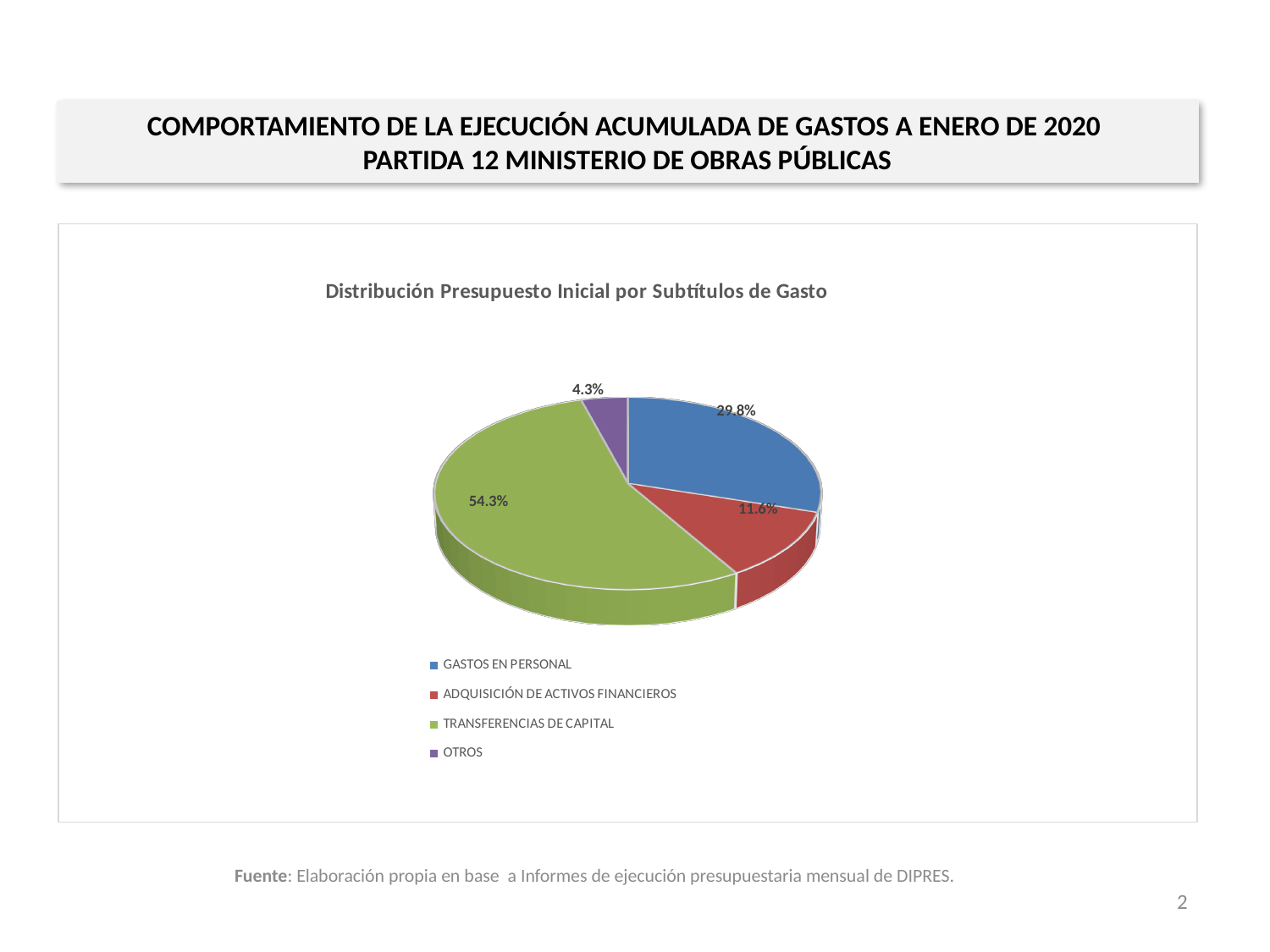
What share of the pie does OTROS represent? 4.3% Which category has the largest share of the pie? TRANSFERENCIAS DE CAPITAL Which is larger, the share for GASTOS EN PERSONAL or the share for ADQUISICIÓN DE ACTIVOS FINANCIEROS? GASTOS EN PERSONAL What share of the pie does ADQUISICIÓN DE ACTIVOS FINANCIEROS represent? 11.6% Which category has the smallest share of the pie? OTROS What is the difference between the share for TRANSFERENCIAS DE CAPITAL and the share for GASTOS EN PERSONAL? 24.5% How many categories does the pie chart show? 4 What share of the pie does GASTOS EN PERSONAL represent? 29.8% What colour is the slice for TRANSFERENCIAS DE CAPITAL? Green What type of chart is shown on the slide? Pie chart What is the title of the chart? Distribución Presupuesto Inicial por Subtítulos de Gasto